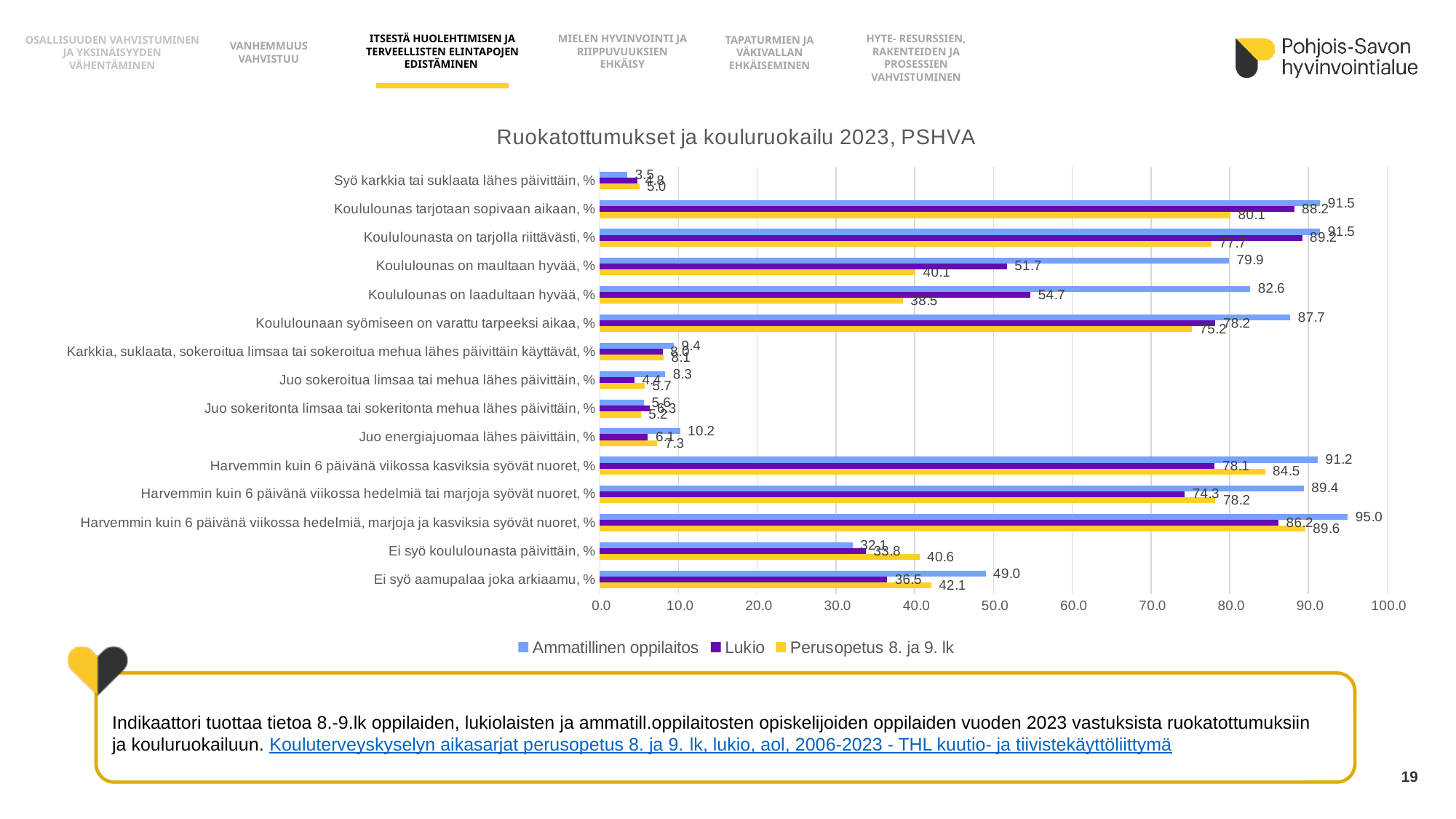
What is the difference between the Ammatillinen oppilaitos and Perusopetus 8. ja 9. lk values for 'Koululounas on maultaan hyvää, %'? 39.8 What is the value for Perusopetus 8. ja 9. lk in the category 'Ei syö koululounasta päivittäin, %'? 40.6 In the category 'Harvemmin kuin 6 päivänä viikossa kasviksia syövät nuoret, %', which is larger: the Lukio value or the Perusopetus 8. ja 9. lk value? Perusopetus 8. ja 9. lk How many categories are plotted on the chart? 15 Is the value for Perusopetus 8. ja 9. lk in 'Koululounas on laadultaan hyvää, %' greater or less than 40.0? less What is the title of the chart? Ruokatottumukset ja kouluruokailu 2023, PSHVA What is the difference between the Ammatillinen oppilaitos and Lukio values for 'Ei syö aamupalaa joka arkiaamu, %'? 12.5 What is the value for Lukio in the category 'Koululounas on laadultaan hyvää, %'? 54.7 What type of chart is shown on the slide? bar chart What is the value for Ammatillinen oppilaitos in the category 'Koululounas on maultaan hyvää, %'? 79.9 Which category has the highest value for Ammatillinen oppilaitos? Harvemmin kuin 6 päivänä viikossa hedelmiä, marjoja ja kasviksia syövät nuoret, % How many series does the legend list? 3